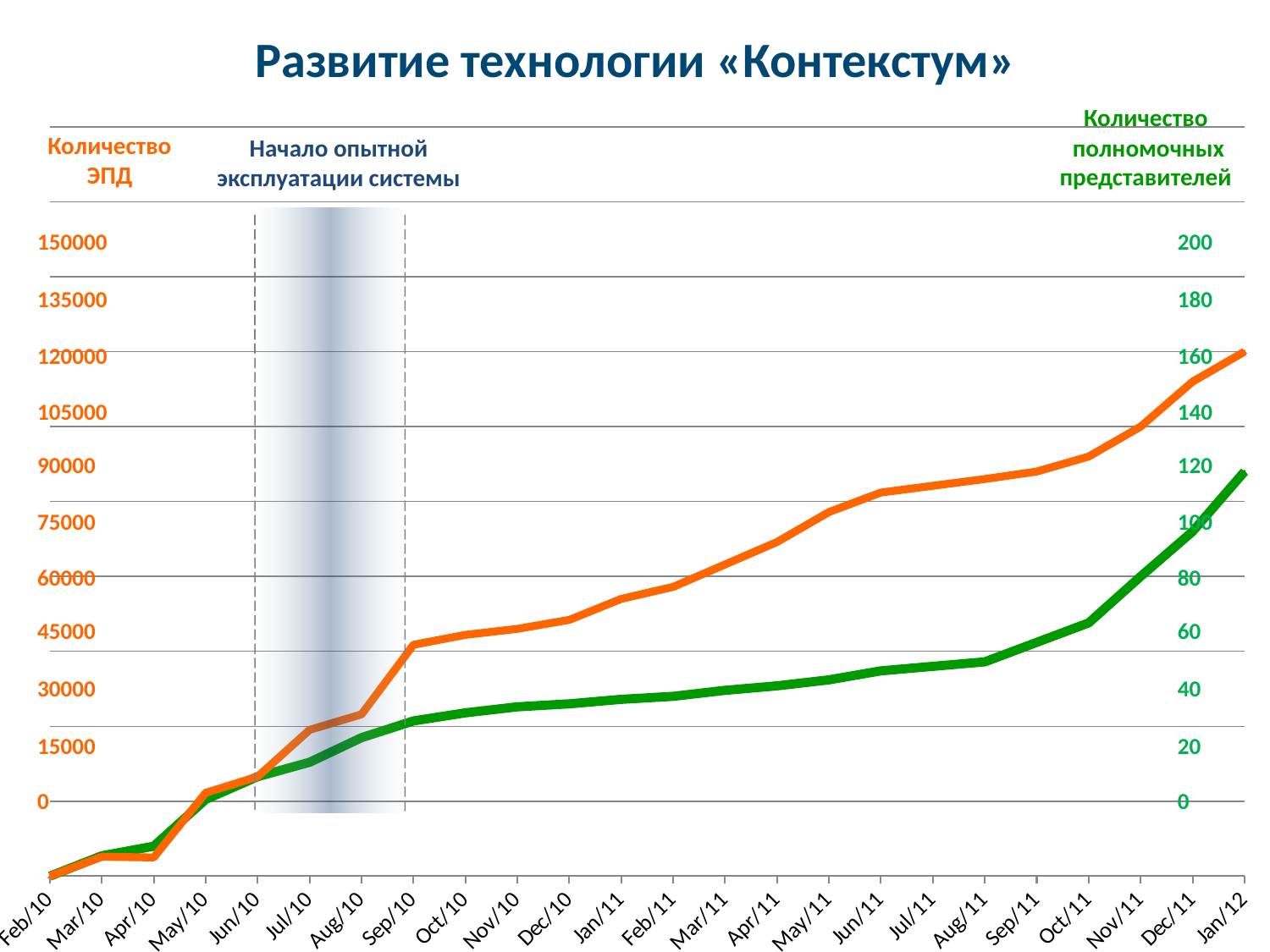
At which month does the orange line (Количество ЭПД) reach its highest value? Jan/12 Is the value of the orange line (Количество ЭПД) at Jan/12 greater or less than 105000? greater How many months are labelled along the x axis? 24 Does the green line (Количество полномочных представителей) rise or fall over the period shown? rise What is the title of the chart? Развитие технологии «Контекстум» Does the orange line (Количество ЭПД) rise or fall from Feb/10 to Jan/12? rise How many data series are plotted on the chart? 2 Which month is the first on the x axis? Feb/10 At which month is the green line (Количество полномочных представителей) at its lowest value? Feb/10 What kind of chart is shown on the slide? line chart Is the value of the orange line (Количество ЭПД) at Jun/11 greater or less than 75000? greater Is the value of the green line (Количество полномочных представителей) at Jan/12 greater or less than 100? greater